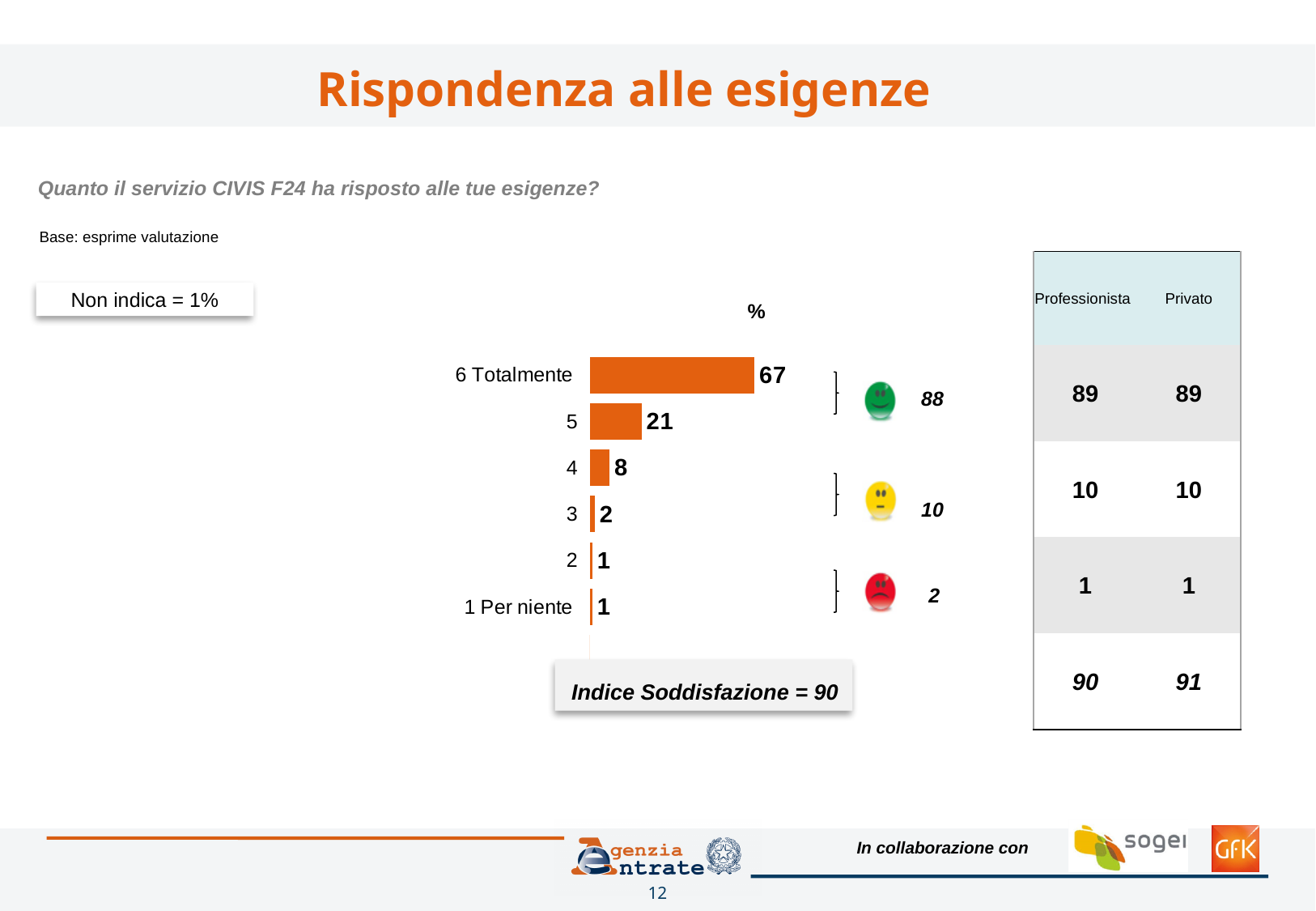
What is the difference between the values for "6 Totalmente" and "5"? 46 Which category has the highest value? 6 Totalmente What kind of chart is shown on the slide? bar chart What is the value for the category "4"? 8 What is the value for the category "5"? 21 What is the value for the category "1 Per niente"? 1 What is the value for the category "6 Totalmente"? 67 What colour are the bars in the chart? orange What is the Indice Soddisfazione shown below the chart? 90 How many categories are shown in the bar chart? 6 Which is larger, the value for "4" or the value for "3"? 4 What is the combined value shown next to the green smiley for categories 6 and 5? 88